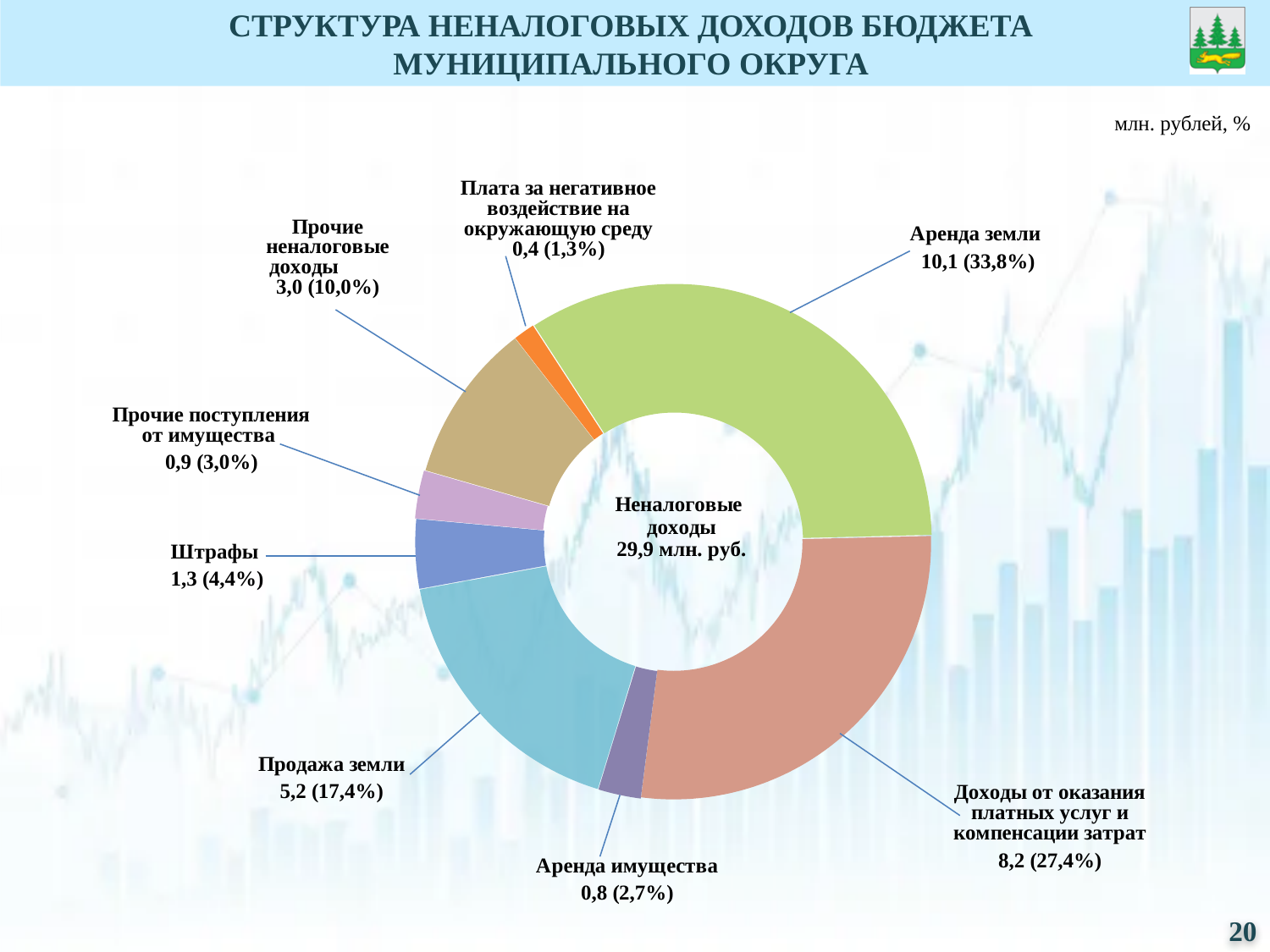
Какова сумма доходов от продажи земли (млн. рублей)? 5,2 Сколько категорий неналоговых доходов показано на диаграмме? 8 Какая категория неналоговых доходов является наибольшей? Аренда земли Какую долю занимают прочие неналоговые доходы? 10,0% Какова сумма доходов от аренды имущества (млн. рублей)? 0,8 Какова общая сумма неналоговых доходов, указанная в центре диаграммы? 29,9 млн. руб. Какой тип диаграммы показан на слайде? Кольцевая (круговая) диаграмма Какова сумма доходов от аренды земли (млн. рублей)? 10,1 На сколько млн. рублей доходы от аренды земли больше доходов от оказания платных услуг и компенсации затрат? 1,9 Какую долю в неналоговых доходах занимают доходы от оказания платных услуг и компенсации затрат? 27,4% Что больше: штрафы или прочие поступления от имущества? Штрафы Какая категория неналоговых доходов является наименьшей? Плата за негативное воздействие на окружающую среду